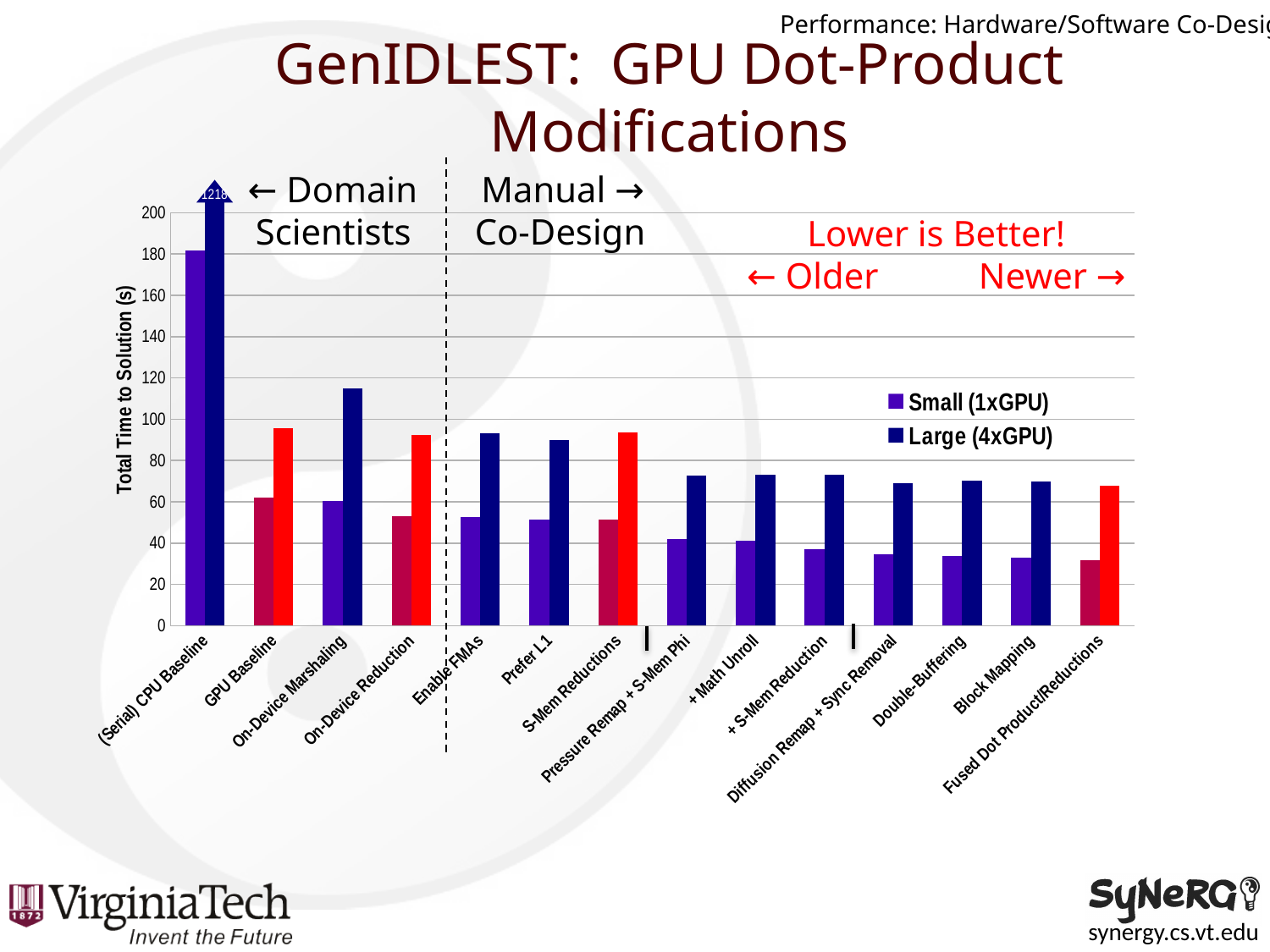
What is the label of the y axis? Total Time to Solution (s) How many categories are shown along the x axis? 14 Is the Large (4xGPU) value for On-Device Marshaling greater or less than 100? greater Which category has the highest Large (4xGPU) value? (Serial) CPU Baseline How many series does the legend list? 2 What kind of chart is shown on the slide? bar chart What is the Large (4xGPU) value for (Serial) CPU Baseline? 1218 Which is larger, the Large (4xGPU) value for On-Device Marshaling or for GPU Baseline? On-Device Marshaling Is the Small (1xGPU) value for (Serial) CPU Baseline greater or less than 160? greater Which category has the highest Small (1xGPU) value? (Serial) CPU Baseline Do the Small (1xGPU) values generally rise or fall from left to right along the x axis? fall Is the Small (1xGPU) value for Fused Dot Product/Reductions greater or less than 40? less